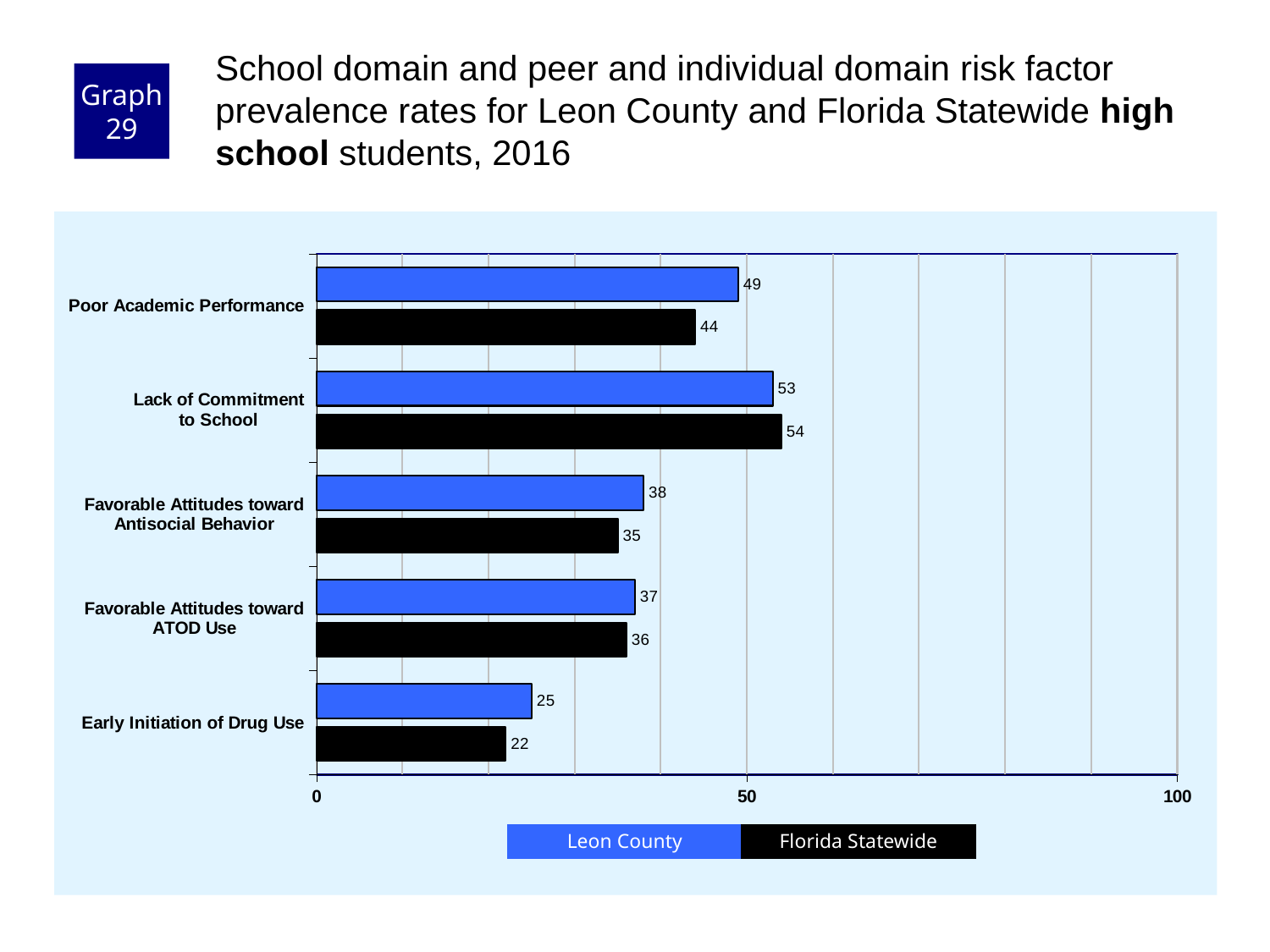
What is the Leon County value for Poor Academic Performance? 49 How many risk factor categories are shown on the chart? 5 How many series does the legend list? 2 Is the Florida Statewide value for Poor Academic Performance greater or less than 50? less What is the Florida Statewide value for Lack of Commitment to School? 54 What is the difference between the Leon County and Florida Statewide values for Poor Academic Performance? 5 What kind of chart is shown on the slide? bar chart Which risk factor has the highest Leon County value? Lack of Commitment to School Which risk factor has the lowest Florida Statewide value? Early Initiation of Drug Use What is the Florida Statewide value for Favorable Attitudes toward ATOD Use? 36 Which is larger for Favorable Attitudes toward Antisocial Behavior, the Leon County value or the Florida Statewide value? Leon County What is the Leon County value for Early Initiation of Drug Use? 25